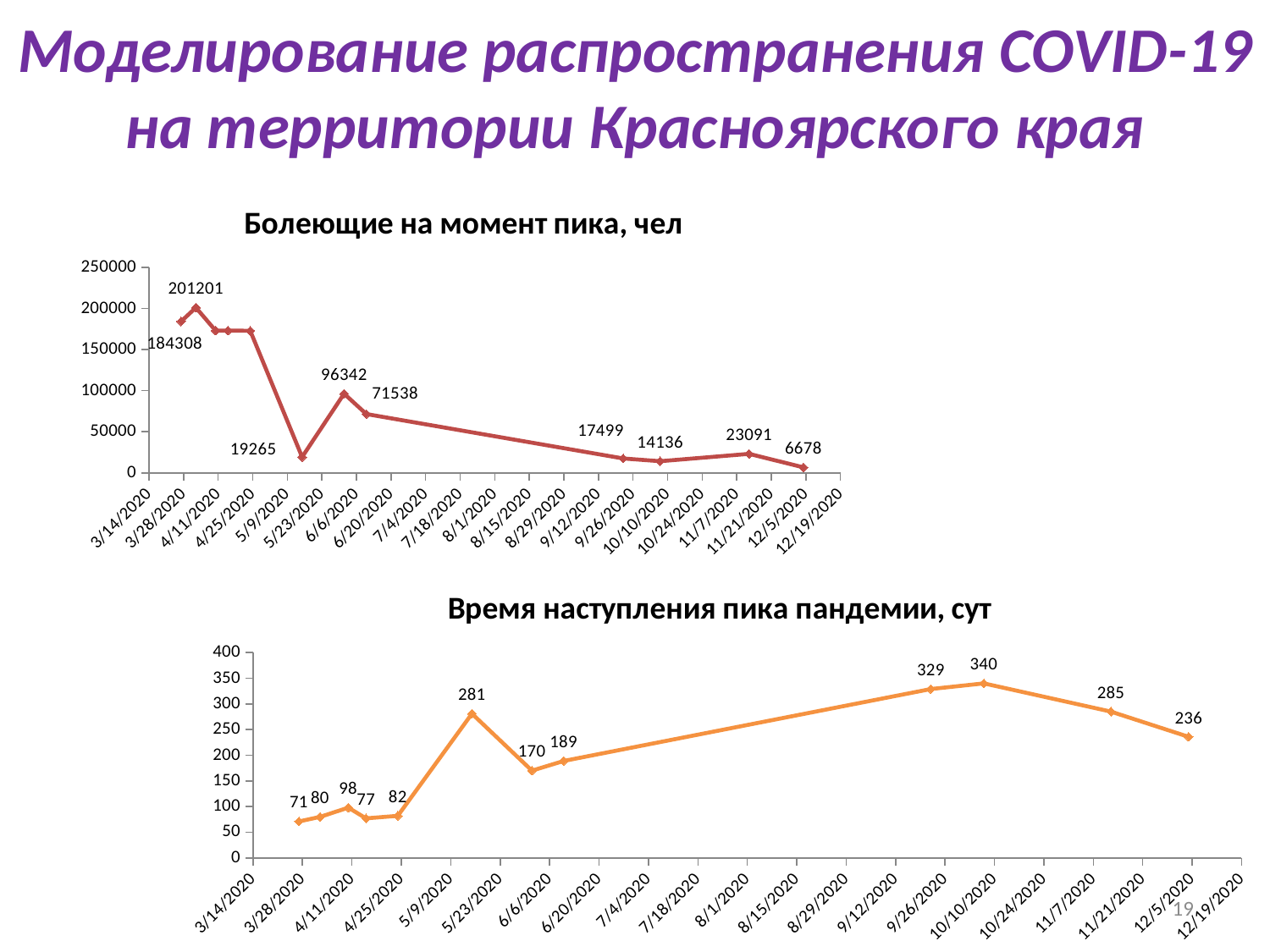
In the bottom chart "Время наступления пика пандемии, сут", what is the difference between the labelled values 281 and 170? 111 In the top chart "Болеющие на момент пика, чел", which is larger: the point labelled 23091 or the point labelled 17499? 23091 In the top chart "Болеющие на момент пика, чел", what is the lowest labelled value? 6678 In the bottom chart "Время наступления пика пандемии, сут", what is the highest labelled value? 340 In the top chart "Болеющие на момент пика, чел", what is the difference between the labelled values 201201 and 184308? 16893 In the top chart "Болеющие на момент пика, чел", do the values generally rise or fall from the first point to the last point? fall What type of chart is the top chart titled "Болеющие на момент пика, чел"? line chart In the bottom chart "Время наступления пика пандемии, сут", how many data points are plotted? 12 In the bottom chart "Время наступления пика пандемии, сут", which is larger: the point labelled 285 or the point labelled 236? 285 In the bottom chart "Время наступления пика пандемии, сут", what is the lowest labelled value? 71 In the top chart "Болеющие на момент пика, чел", what is the highest labelled value? 201201 What is the highest value shown on the y axis of the bottom chart "Время наступления пика пандемии, сут"? 400